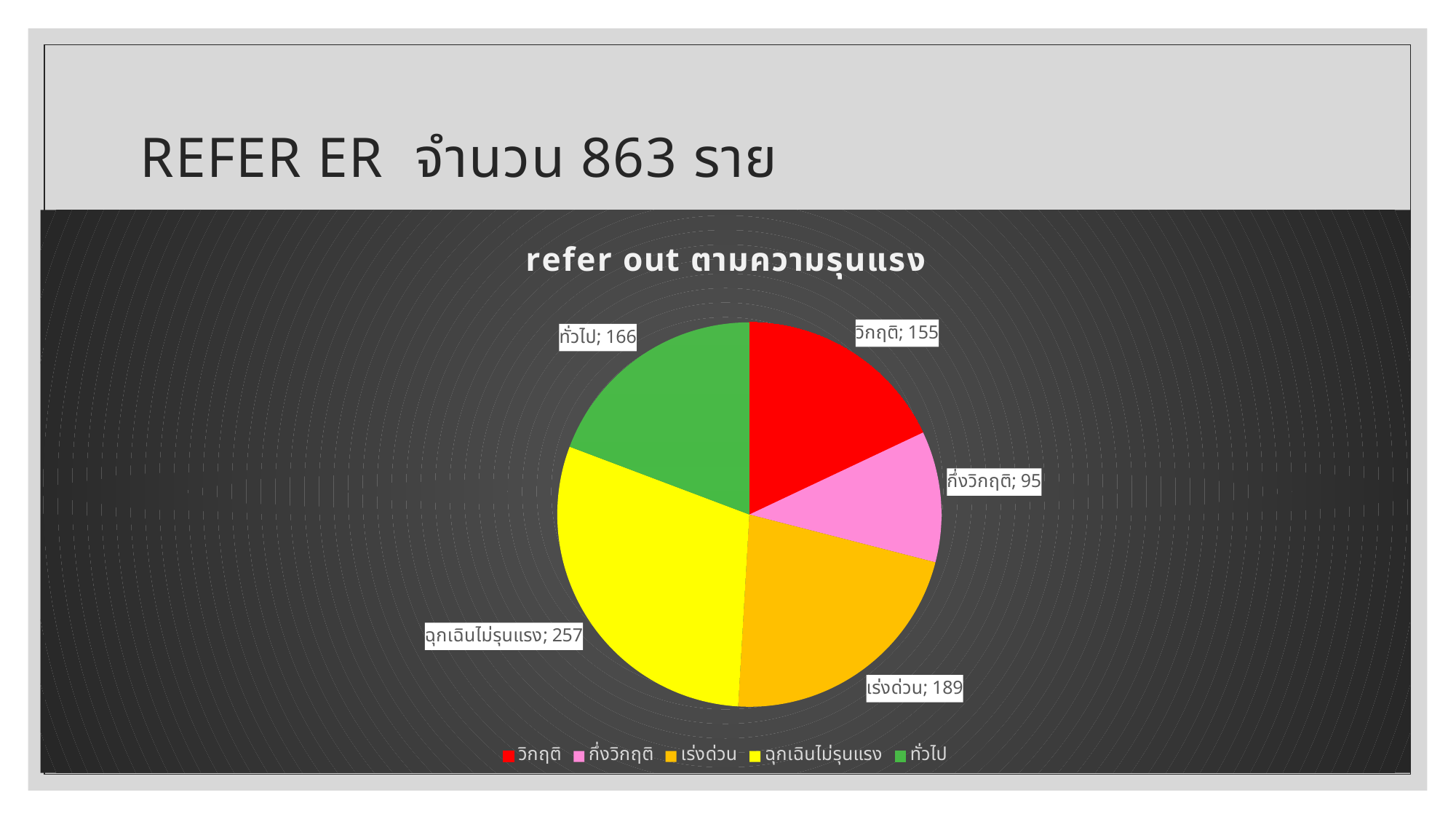
How many slices does the pie chart have? 5 What is the title of the chart? refer out ตามความรุนแรง What is the difference between the values for ฉุกเฉินไม่รุนแรง and เร่งด่วน? 68 What type of chart is shown on the slide? pie chart Which category has the smallest slice? กึ่งวิกฤติ What is the value for เร่งด่วน? 189 What is the value for กึ่งวิกฤติ? 95 What is the value for ฉุกเฉินไม่รุนแรง? 257 What is the value for วิกฤติ? 155 What is the value for ทั่วไป? 166 Which is larger, the value for ทั่วไป or the value for วิกฤติ? ทั่วไป Which category has the largest slice? ฉุกเฉินไม่รุนแรง